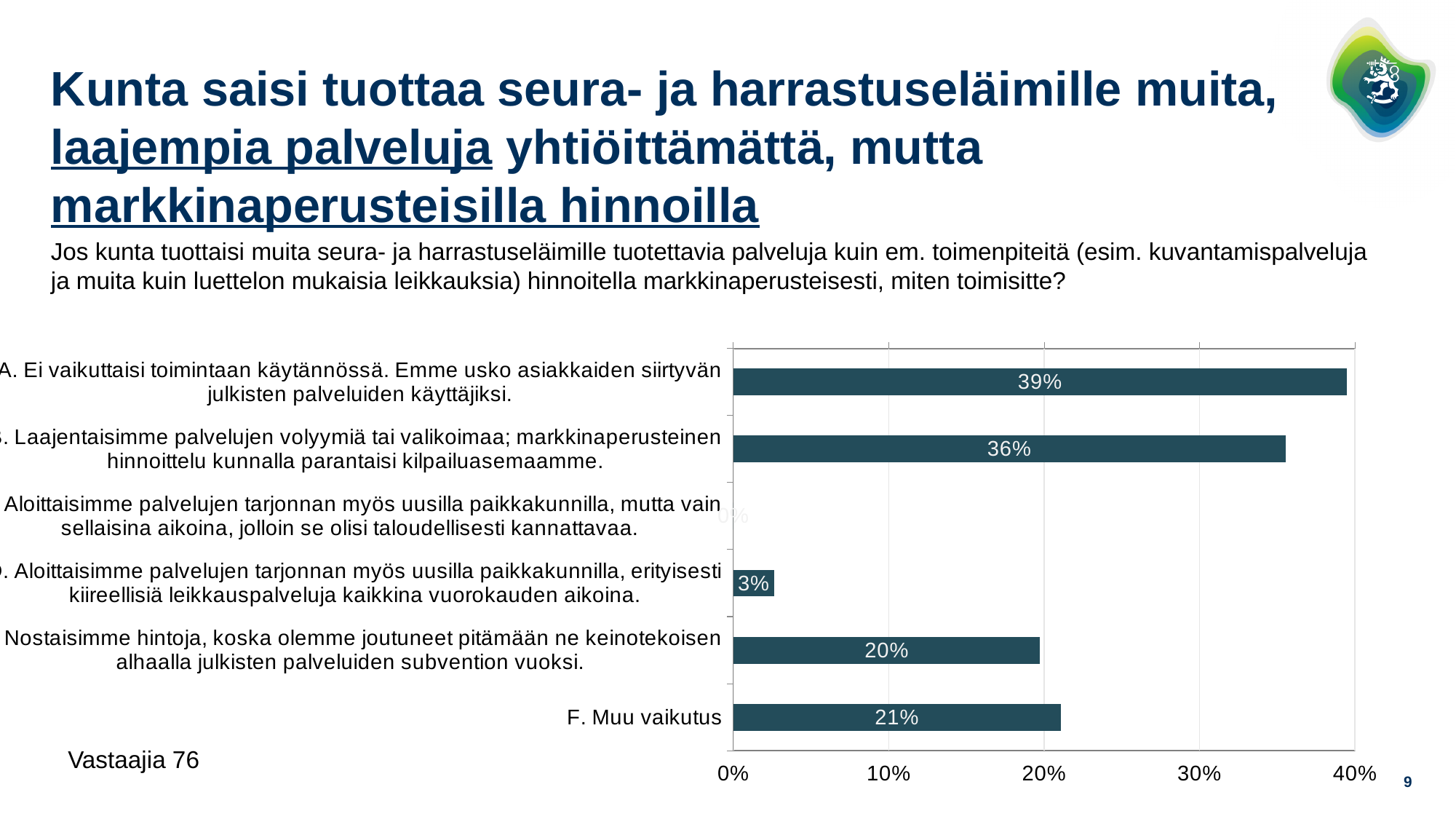
How many categories (response options) does the chart show? 6 What is the value for the option "Laajentaisimme palvelujen volyymiä tai valikoimaa"? 36% What is the value for "F. Muu vaikutus"? 21% Which is larger: the value for "F. Muu vaikutus" or the value for "Nostaisimme hintoja"? F. Muu vaikutus What is the difference between the value for option A (39%) and the value for "F. Muu vaikutus" (21%)? 18% What is the value for the option "Nostaisimme hintoja, koska olemme joutuneet pitämään ne keinotekoisen alhaalla"? 20% What is the value for the option about offering services in new locations, especially urgent surgical services at all hours of the day? 3% What kind of chart is shown on the slide? bar chart Which option has the highest value? A. Ei vaikuttaisi toimintaan käytännössä Is the value for "Laajentaisimme palvelujen volyymiä tai valikoimaa" greater or less than 30%? greater How many respondents (Vastaajia) does the slide report? 76 What is the value for option A, "Ei vaikuttaisi toimintaan käytännössä"? 39%